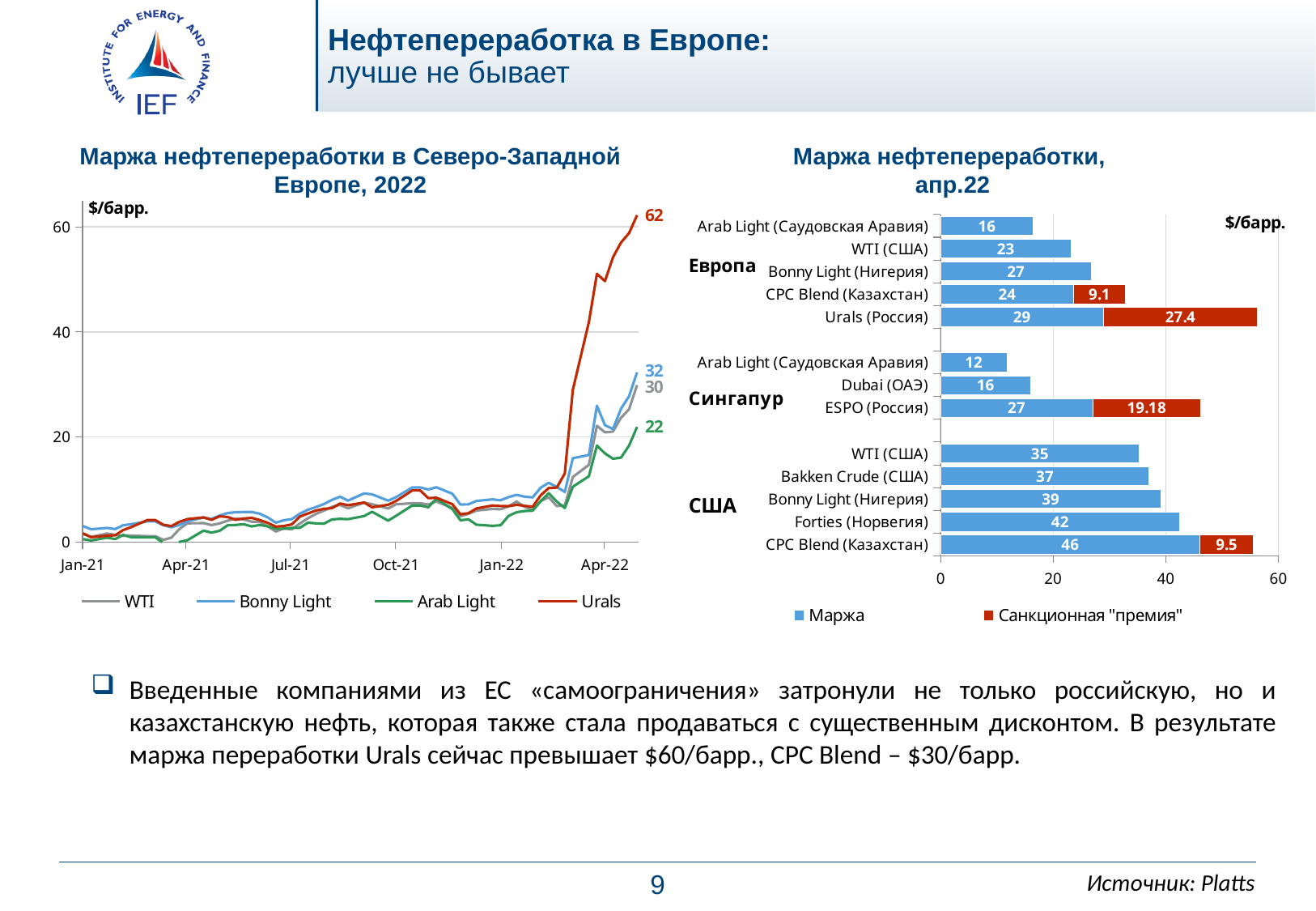
What kind of chart is 'Маржа нефтепереработки в Северо-Западной Европе, 2022'? Line chart On the chart 'Маржа нефтепереработки, апр.22', which category in the США group has the highest margin (Маржа)? CPC Blend (Казахстан) On the chart 'Маржа нефтепереработки, апр.22', which is larger: the margin for WTI (США) in the Европа group or the margin for WTI (США) in the США group? WTI (США) in the США group On the chart 'Маржа нефтепереработки в Северо-Западной Европе, 2022', what is the final labelled value for Arab Light? 22 What kind of chart is 'Маржа нефтепереработки, апр.22'? Bar chart On the chart 'Маржа нефтепереработки в Северо-Западной Европе, 2022', how many series does the legend list? 4 On the chart 'Маржа нефтепереработки, апр.22', what is the margin (Маржа) for Urals (Россия)? 29 On the chart 'Маржа нефтепереработки в Северо-Западной Европе, 2022', what is the final labelled value for Urals? 62 On the chart 'Маржа нефтепереработки в Северо-Западной Европе, 2022', what is the difference between the final labelled values of Urals and Bonny Light? 30 On the chart 'Маржа нефтепереработки, апр.22', what is the total of the stacked bar for CPC Blend (Казахстан) in the США group? 55.5 On the chart 'Маржа нефтепереработки в Северо-Западной Европе, 2022', which series ends at the highest labelled value? Urals On the chart 'Маржа нефтепереработки, апр.22', what is the sanction premium (Санкционная "премия") for ESPO (Россия)? 19.18